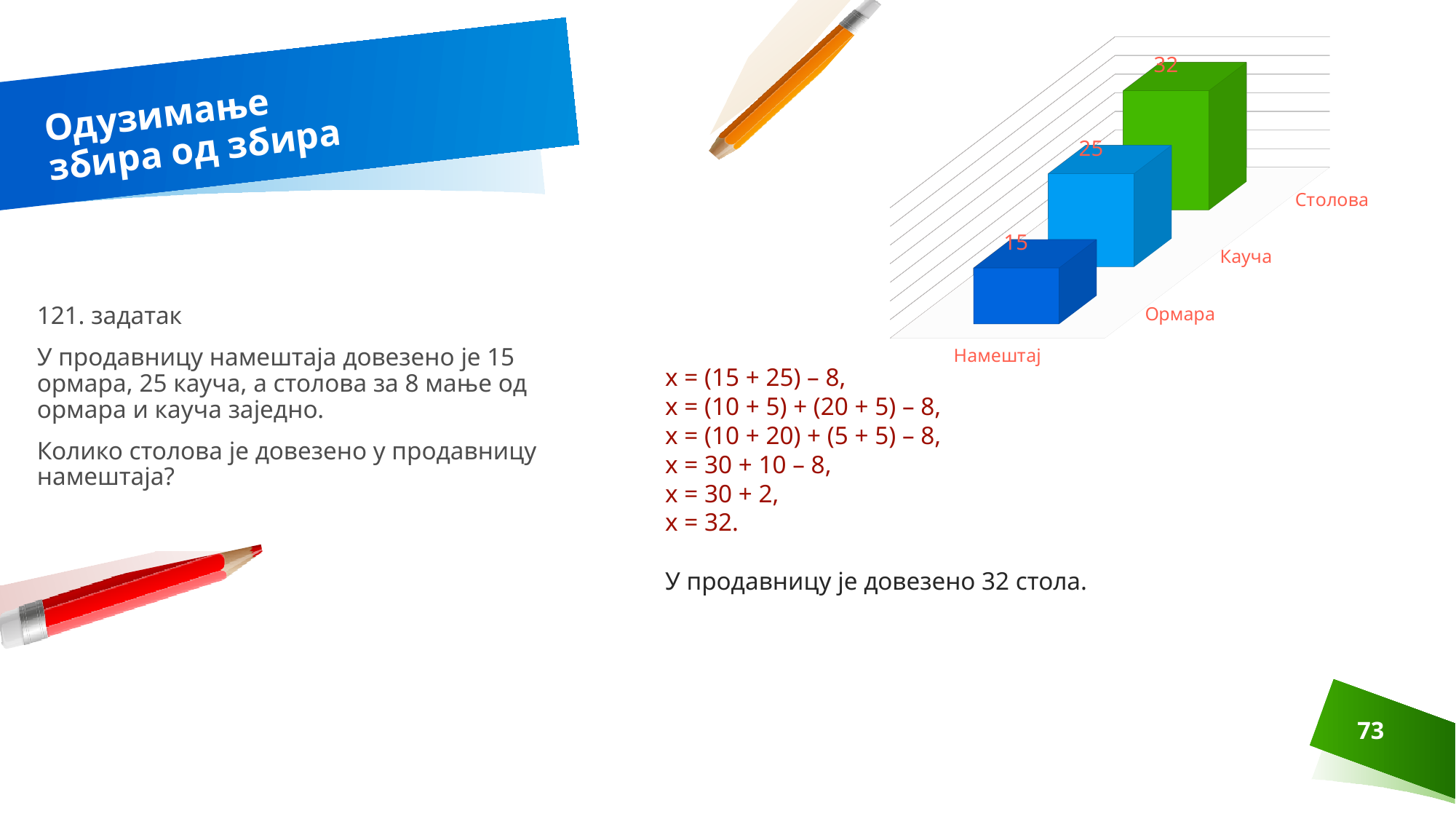
Which category has the highest value in the chart? Столова What value is shown for Столова in the chart? 32 Which is larger, the value for Кауча or the value for Столова? Столова How many categories are shown in the chart? 3 What is the difference between the values for Кауча and Ормара? 10 What value is shown for Ормара in the chart? 15 Do the values rise or fall going from Ормара to Столова? rise What is the axis label shown below the categories in the chart? Намештај Which category has the lowest value in the chart? Ормара What value is shown for Кауча in the chart? 25 What kind of chart is shown on the slide? bar chart What is the difference between the values for Столова and Ормара? 17